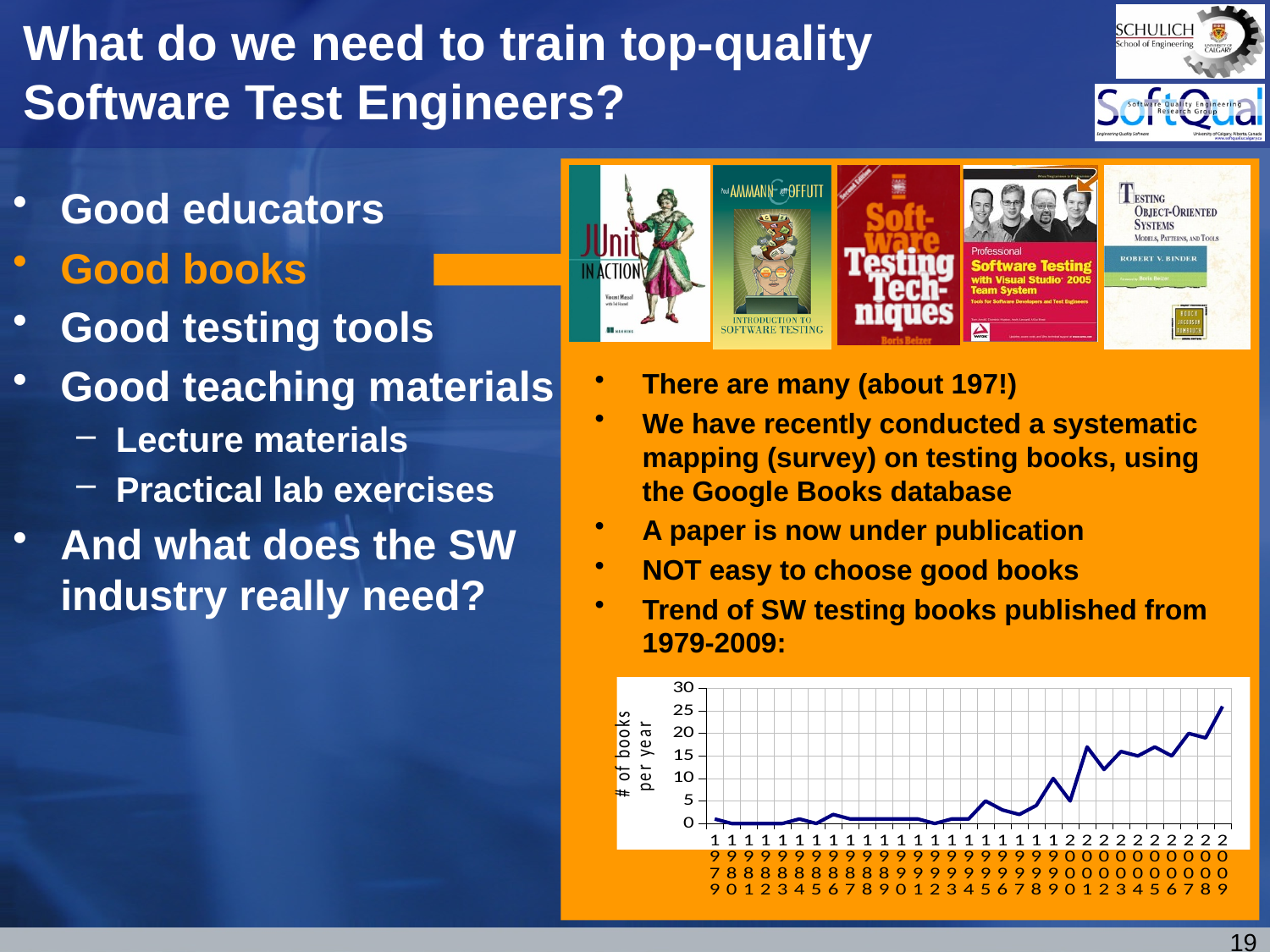
Is the value for 1990 greater or less than 5? less Overall, do the values in the chart rise or fall from 1979 to 2009? rise Which year has the highest number of books per year in the chart? 2009 Is the value for 1979 greater or less than 5? less What range of years does the chart's x axis cover? 1979 to 2009 Is the value for 2009 greater or less than 20? greater What is the label on the vertical axis of the chart? # of books per year Which year has the larger value in the chart, 1985 or 2009? 2009 How many years (data points) are plotted along the x axis of the chart? 31 What is the highest tick value shown on the chart's vertical axis? 30 What kind of chart is shown at the bottom right of the slide? line chart